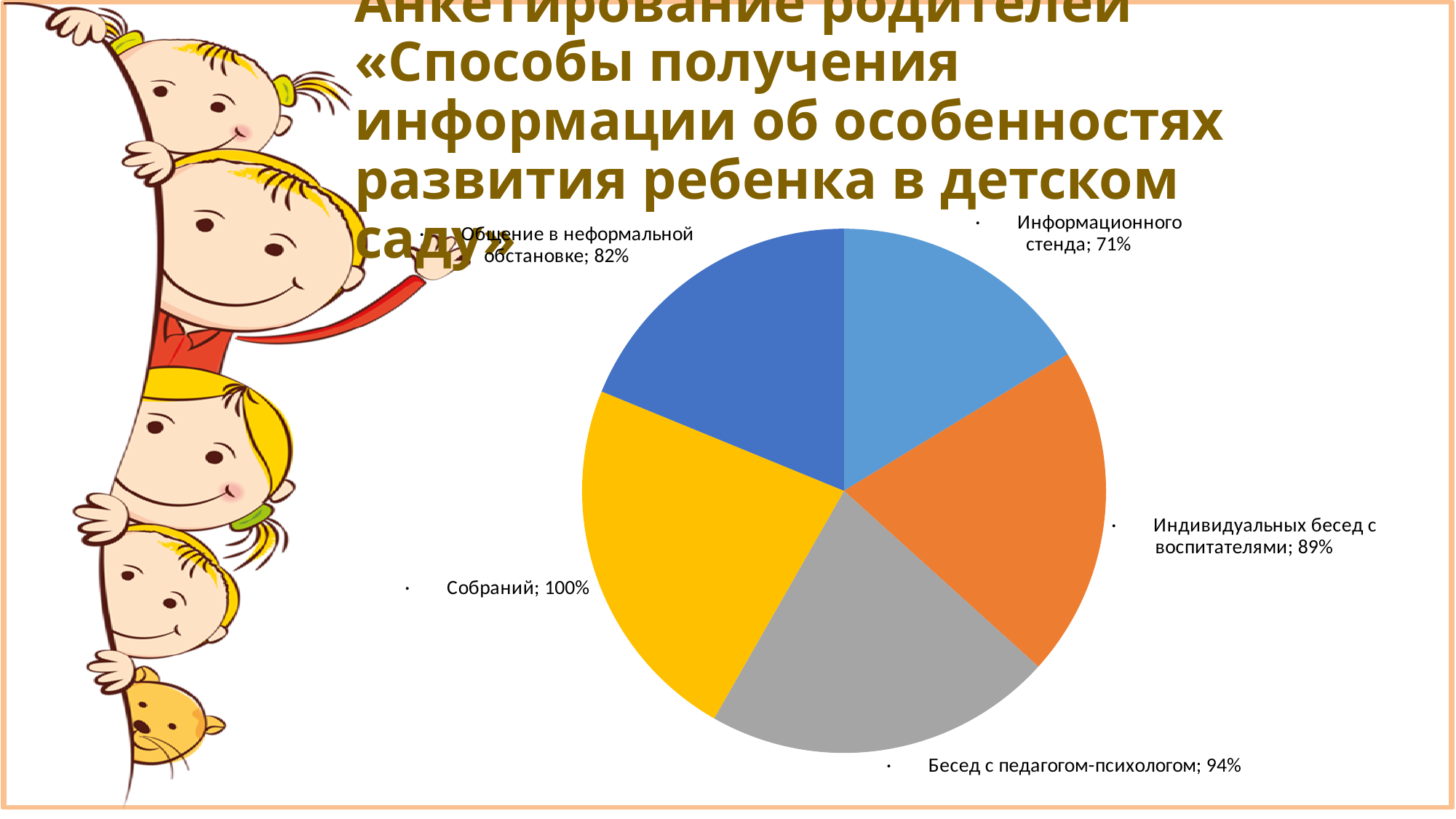
Which category has the highest value? Собраний How many slices does the pie chart have? 5 Which is larger: the value for «Бесед с педагогом-психологом» or for «Индивидуальных бесед с воспитателями»? Бесед с педагогом-психологом What value is shown for «Бесед с педагогом-психологом»? 94% What value is shown for «Собраний»? 100% Which category has the lowest value? Информационного стенда What kind of chart is shown on the slide? pie chart What colour is the slice for «Собраний»? yellow What value is shown for «Индивидуальных бесед с воспитателями»? 89% What is the difference between the values for «Собраний» and «Информационного стенда»? 29% What value is shown for «Общение в неформальной обстановке»? 82% What value is shown for «Информационного стенда»? 71%